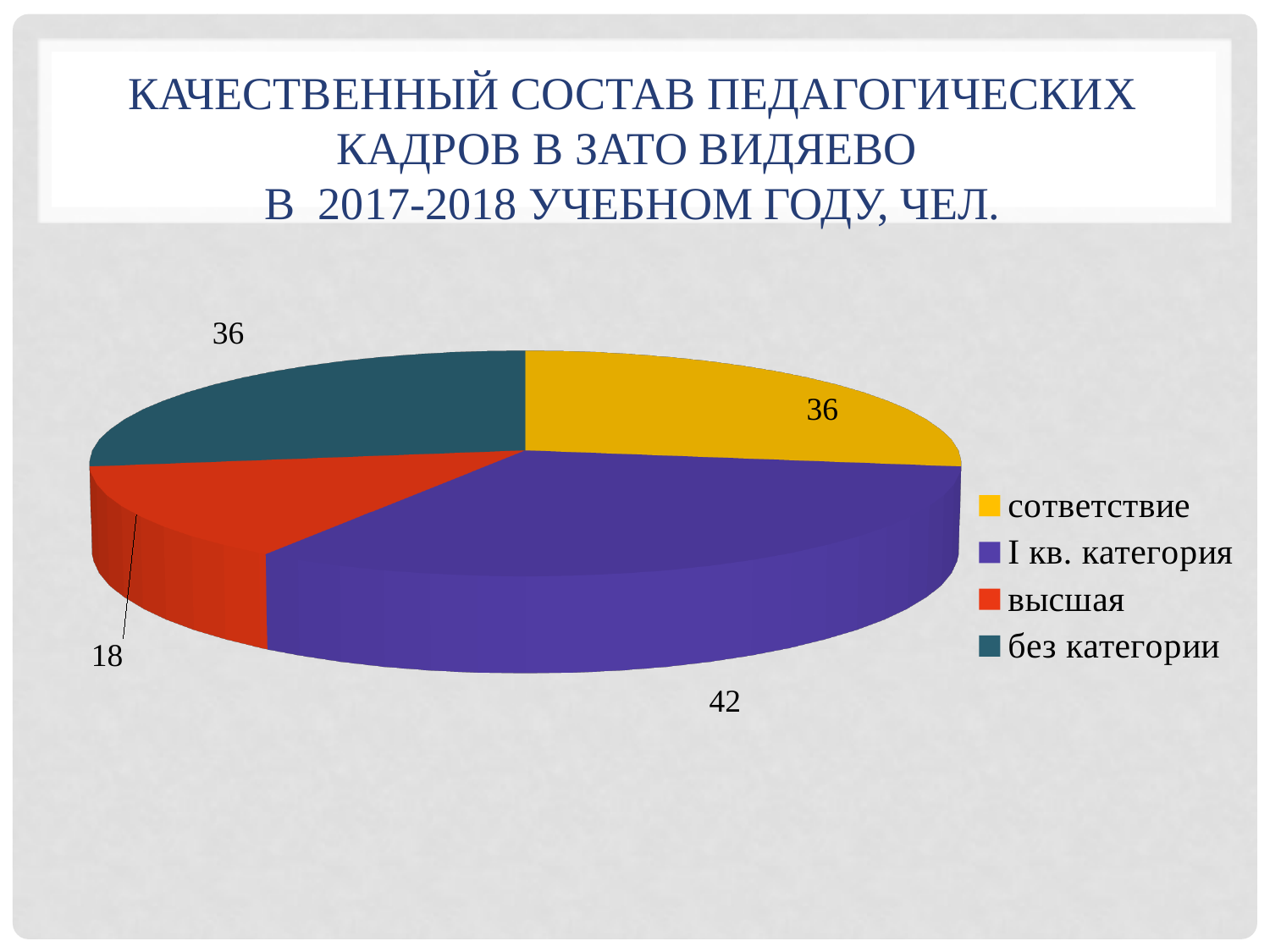
What colour is the 'без категории' slice? Dark teal Which category has the smallest slice of the pie? высшая What is the value for the 'без категории' slice? 36 What is the value for the 'сответствие' slice? 36 What is the value for the 'высшая' slice? 18 Which category has the largest slice of the pie? I кв. категория What is the difference between the values for 'сответствие' and 'высшая'? 18 What is the difference between the values for 'I кв. категория' and 'высшая'? 24 What kind of chart is shown on the slide? Pie chart Which is larger, the value for 'I кв. категория' or the value for 'без категории'? I кв. категория How many slices does the pie chart have? 4 What is the value for the 'I кв. категория' slice? 42